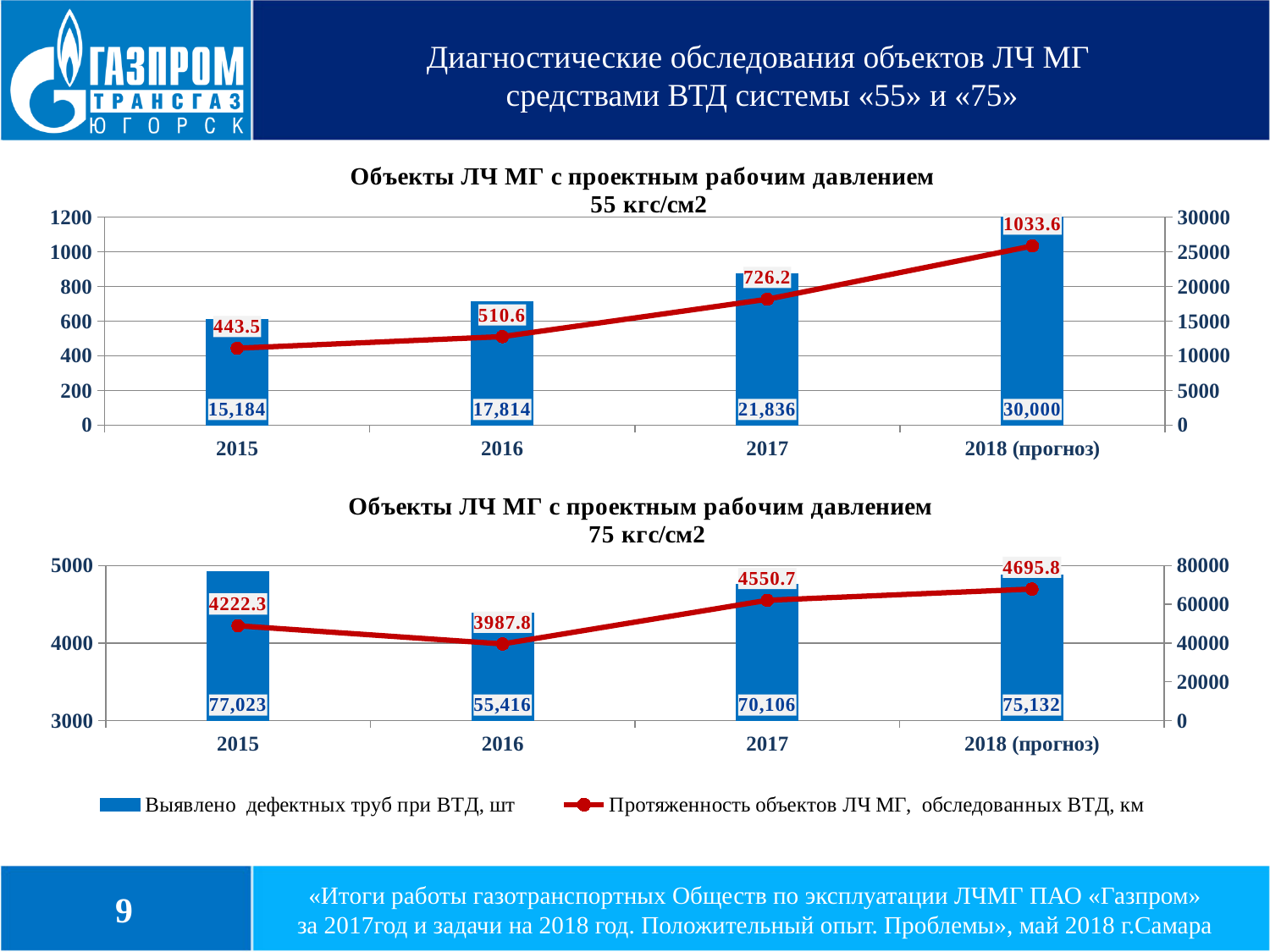
In the bottom chart (75 кгс/см2), which bar is larger: 2015 or 2016? 2015 Does the line series in the top chart (55 кгс/см2) rise or fall from 2015 to 2018 (прогноз)? rise In the top chart (55 кгс/см2), what is the difference between the bar values for 2018 (прогноз) and 2017? 8,164 How many years (categories) are shown on the x axis of the top chart (55 кгс/см2)? 4 In the top chart (55 кгс/см2), what is the value of the line series (Протяженность объектов ЛЧ МГ, обследованных ВТД, км) for 2017? 726.2 In the bottom chart (75 кгс/см2), what is the difference between the line values for 2017 and 2016? 562.9 In the top chart (55 кгс/см2), which year has the highest bar value? 2018 (прогноз) In the bottom chart (75 кгс/см2), which year has the lowest line value? 2016 In the bottom chart (75 кгс/см2), what is the bar value for 2015? 77,023 How many series does the legend at the bottom of the slide list? 2 In the top chart (55 кгс/см2), how many defective pipes (Выявлено дефектных труб при ВТД, шт) are shown for 2016? 17,814 In the bottom chart (75 кгс/см2), what is the line value for 2018 (прогноз)? 4695.8